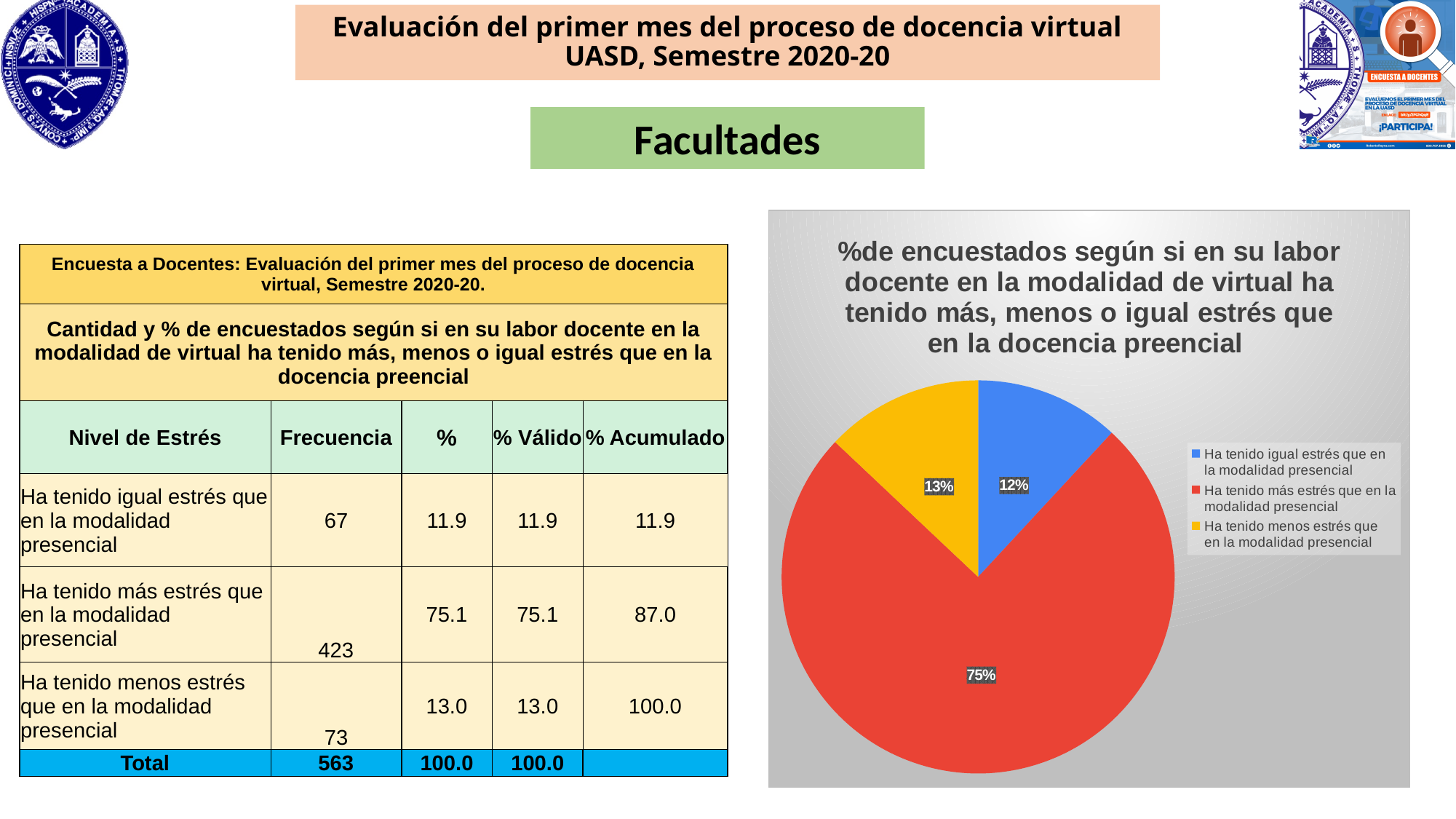
How many entries does the legend of the pie chart list? 3 How many slices does the pie chart have? 3 What percentage of respondents reported having less stress than in the in-person modality ("Ha tenido menos estrés que en la modalidad presencial")? 13% Which slice is larger: "Ha tenido menos estrés" or "Ha tenido igual estrés"? Ha tenido menos estrés que en la modalidad presencial What percentage of respondents reported having more stress in the virtual modality than in the in-person modality ("Ha tenido más estrés que en la modalidad presencial")? 75% What percentage of respondents reported having the same stress as in the in-person modality ("Ha tenido igual estrés que en la modalidad presencial")? 12% What colour is the slice for "Ha tenido menos estrés que en la modalidad presencial"? yellow What is the difference in percentage points between the "más estrés" slice and the "menos estrés" slice? 62 Which category has the largest slice of the pie chart? Ha tenido más estrés que en la modalidad presencial What colour is the slice for "Ha tenido más estrés que en la modalidad presencial"? red What kind of chart is shown on the slide? pie chart Which category has the smallest slice of the pie chart? Ha tenido igual estrés que en la modalidad presencial